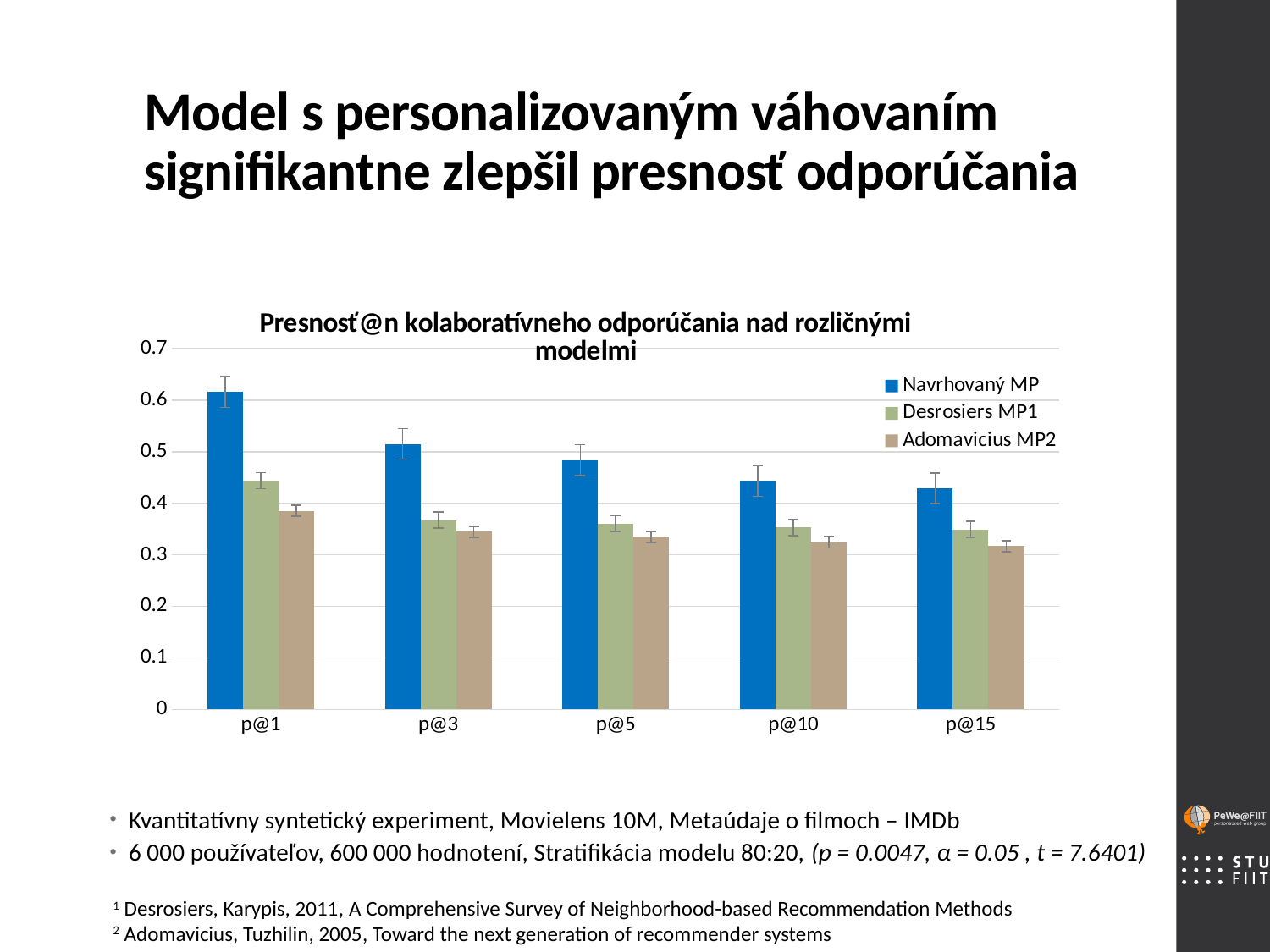
Do the Navrhovaný MP values rise or fall from p@1 to p@15? fall At p@1, which series has the larger value: Desrosiers MP1 or Adomavicius MP2? Desrosiers MP1 Is the value for Desrosiers MP1 at p@5 greater or less than 0.4? less How many categories are shown on the x axis? 5 What kind of chart is shown on the slide? bar chart For which category is the Navrhovaný MP value highest? p@1 Is the value for Adomavicius MP2 at p@15 greater or less than 0.4? less What colour are the bars for the Navrhovaný MP series? blue At p@1, which series has the larger value: Navrhovaný MP or Desrosiers MP1? Navrhovaný MP How many series does the legend list? 3 Is the value for Navrhovaný MP at p@1 greater or less than 0.5? greater For which category is the Adomavicius MP2 value lowest? p@15